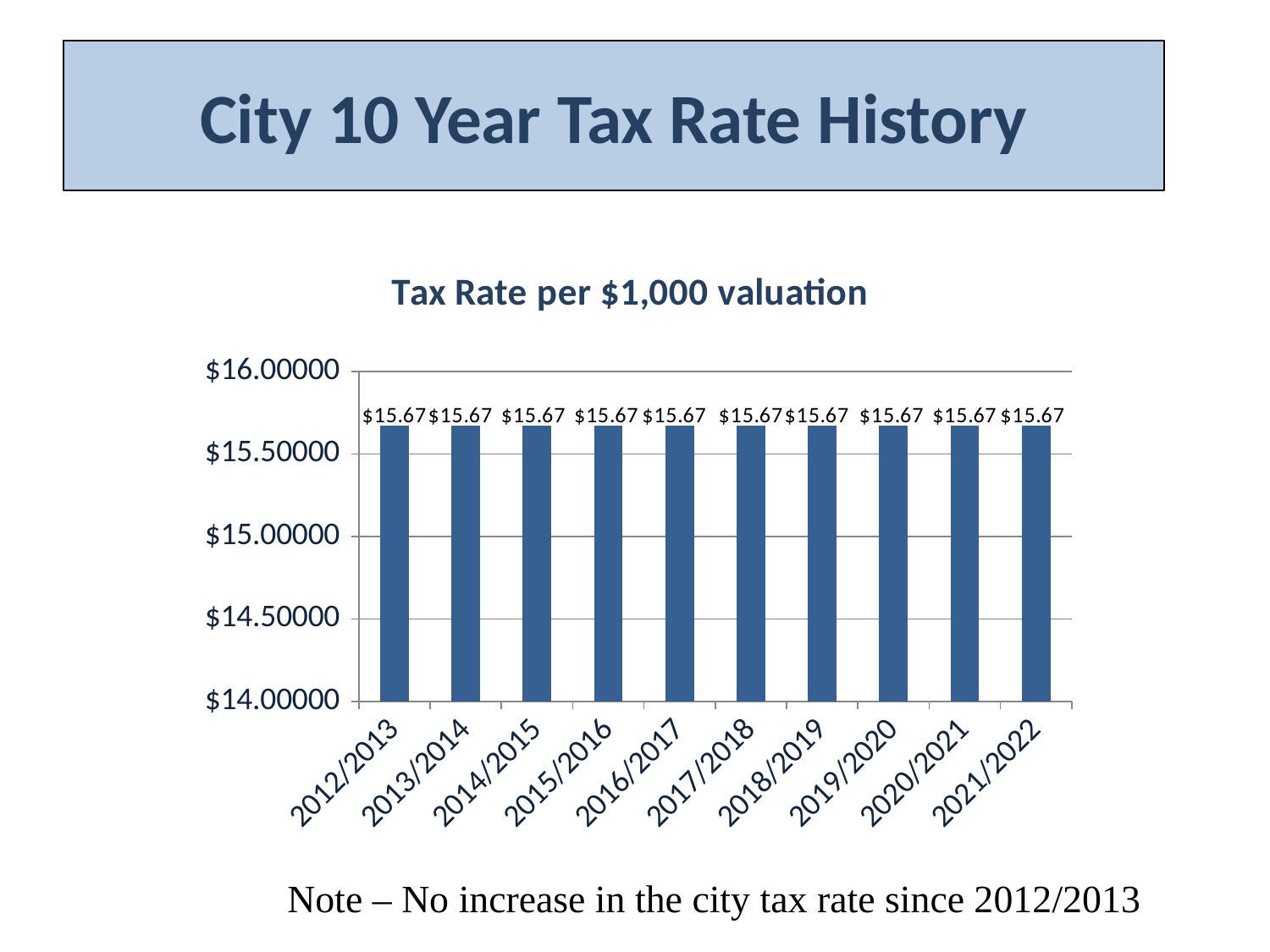
Do the tax rate values rise, fall, or stay the same from 2012/2013 to 2021/2022? Stay the same How many fiscal years are shown on the x axis of the chart? 10 What is the tax rate per $1,000 valuation for 2021/2022? $15.67 What is the title of the chart? Tax Rate per $1,000 valuation What kind of chart is used to show the tax rate history? Bar chart What is the difference between the tax rate for 2012/2013 and the tax rate for 2021/2022? $0.00 What is the lowest value shown on the vertical axis of the chart? $14.00000 Is the tax rate for 2015/2016 greater or less than $15.50000? greater What is the tax rate per $1,000 valuation for 2012/2013? $15.67 What is the tax rate per $1,000 valuation for 2017/2018? $15.67 Is the tax rate for 2019/2020 greater or less than $16.00000? less